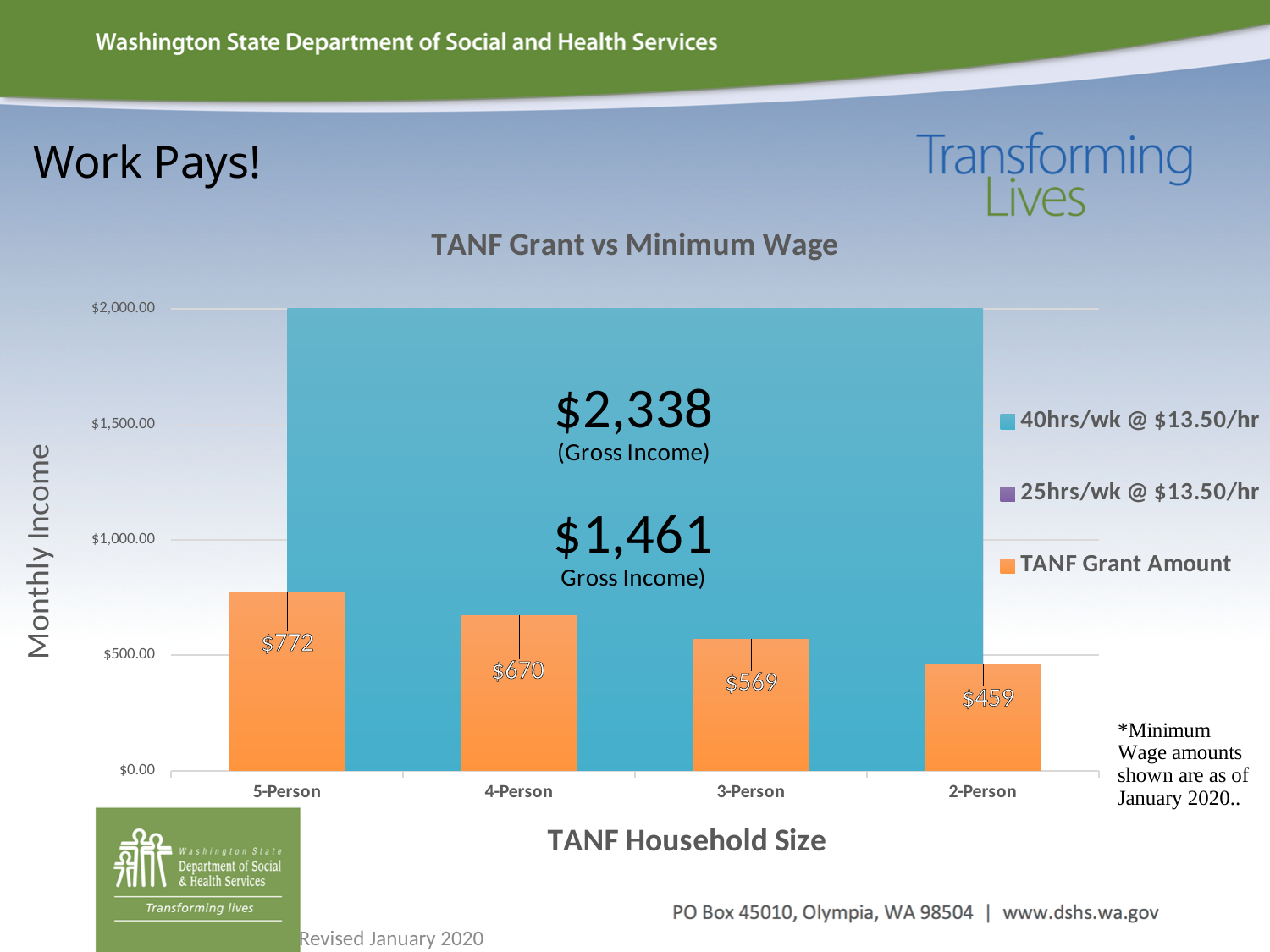
How many household size categories are shown on the x axis? 4 What is the TANF Grant Amount for a 3-Person household? $569 How many series does the legend list? 3 What is the TANF Grant Amount for a 4-Person household? $670 Is the TANF Grant Amount for a 2-Person household greater or less than $500.00? less What is the TANF Grant Amount for a 5-Person household? $772 What is the TANF Grant Amount for a 2-Person household? $459 What is the difference between the TANF Grant Amount for a 5-Person household and a 2-Person household? $313 Which household size has the highest TANF Grant Amount? 5-Person What is the title of the chart? TANF Grant vs Minimum Wage Which is larger, the TANF Grant Amount for a 4-Person household or a 3-Person household? 4-Person Which household size has the lowest TANF Grant Amount? 2-Person